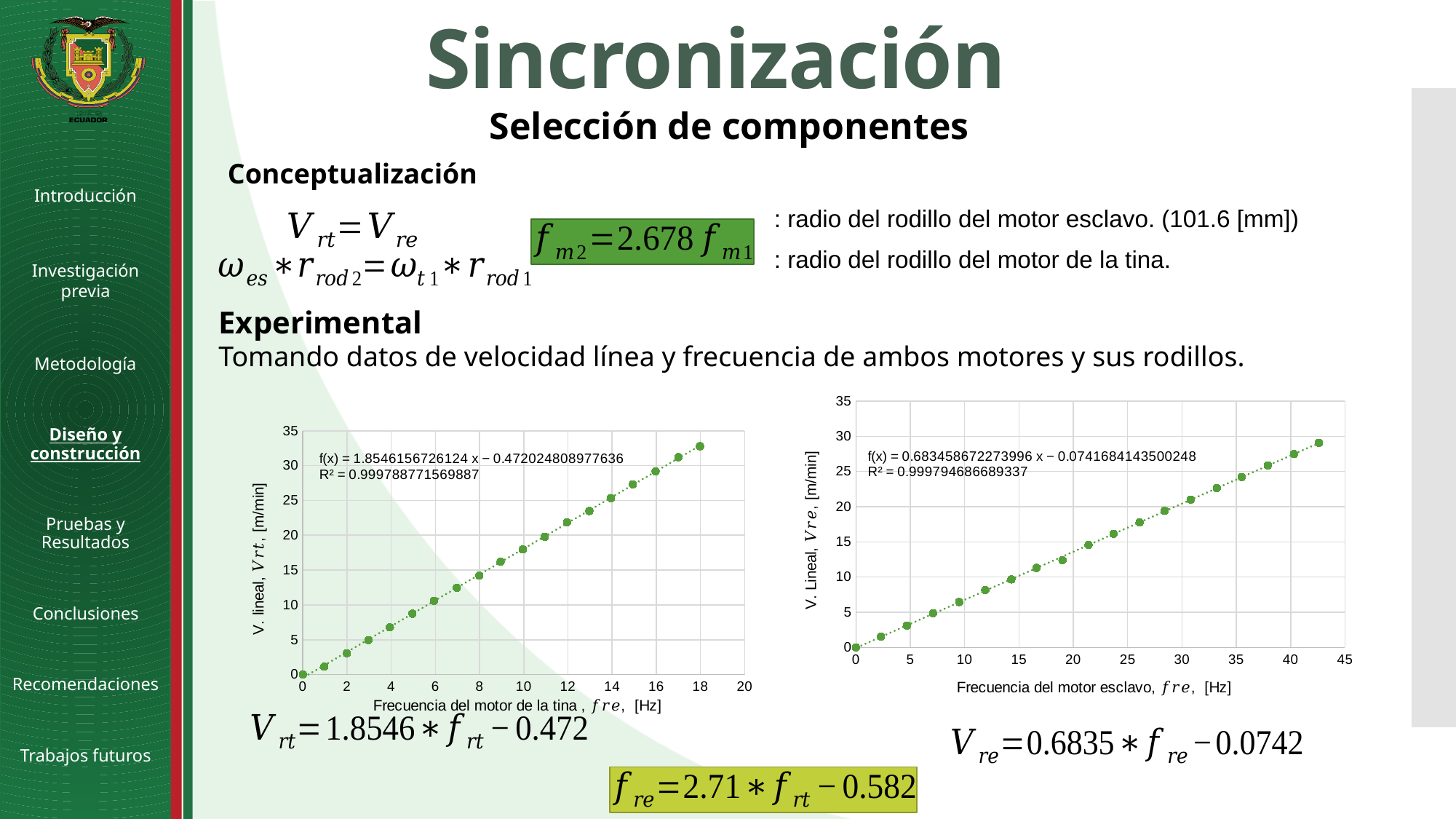
In the left chart, which is larger: the value at 10 Hz or the value at 4 Hz? the value at 10 Hz What kind of chart is the right chart (V. Lineal Vre vs Frecuencia del motor esclavo)? scatter chart What kind of chart is the left chart (V. lineal Vrt vs Frecuencia del motor de la tina)? scatter chart In the left chart, do the values rise or fall as the frequency increases along the x axis? rise What is the trendline equation shown on the right chart? f(x) = 0.683458672273996 x − 0.0741684143500248 In the left chart, is the value at a frequency of 10 Hz greater or less than 15? greater In the right chart, is the highest plotted value greater or less than 30? less In the left chart, is the value at a frequency of 18 Hz greater or less than 30? greater What is the R² value shown on the left chart? 0.999788771569887 In the right chart, do the values rise or fall as the frequency increases along the x axis? rise